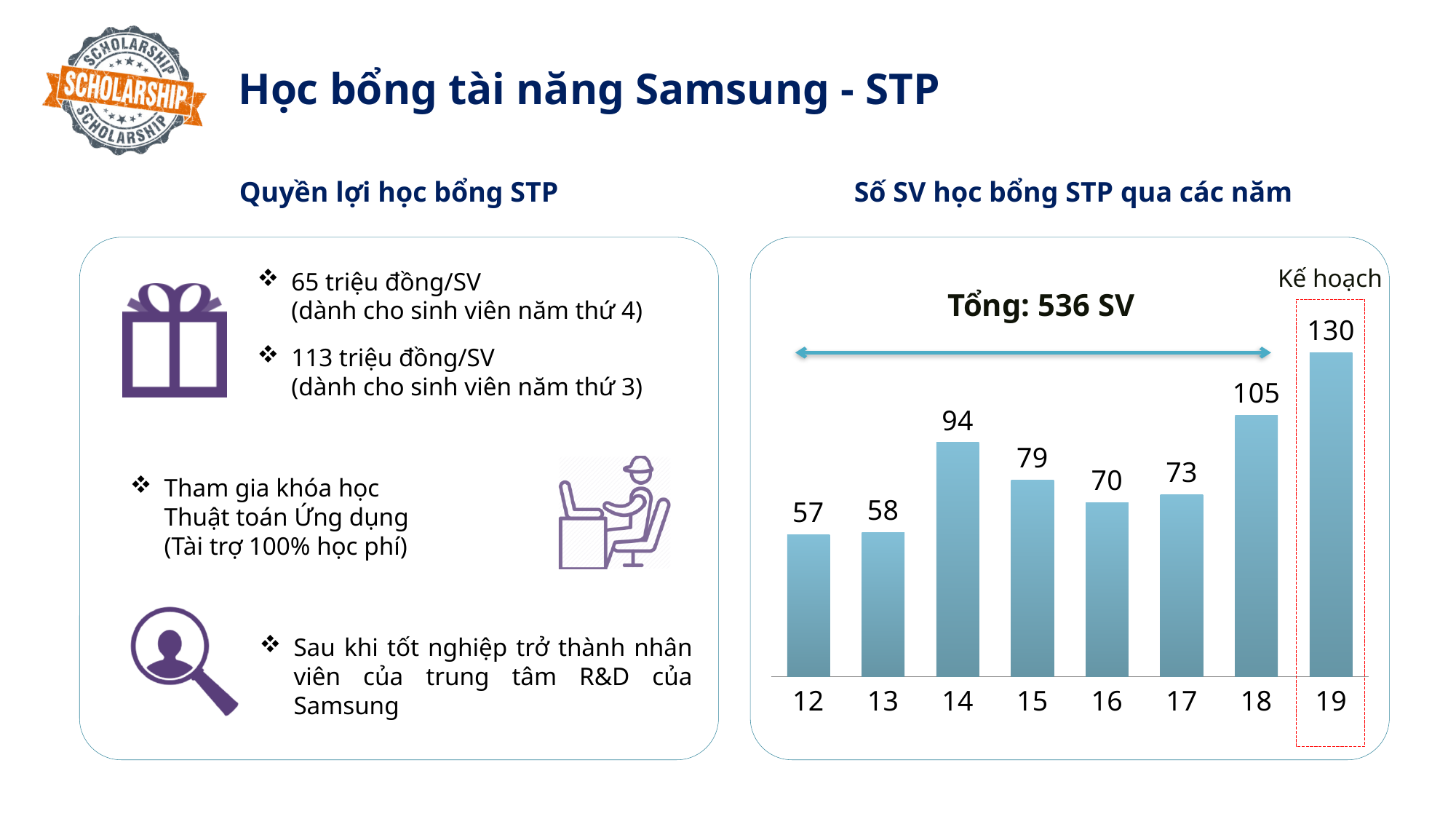
What is the planned (Kế hoạch) value for year 19? 130 What total is stated above the bars in the chart? Tổng: 536 SV What is the difference between the values for year 14 and year 15? 15 Which year has the highest value in the chart? 19 What is the value for year 18 in the chart? 105 Which is larger, the value for year 15 or the value for year 16? 15 Do the values rise or fall from year 16 to year 19? rise What is the value for year 14 in the chart? 94 What type of chart is shown on the slide? bar chart What is the difference between the values for year 18 and year 17? 32 How many bars are shown in the chart? 8 Which year has the lowest value in the chart? 12